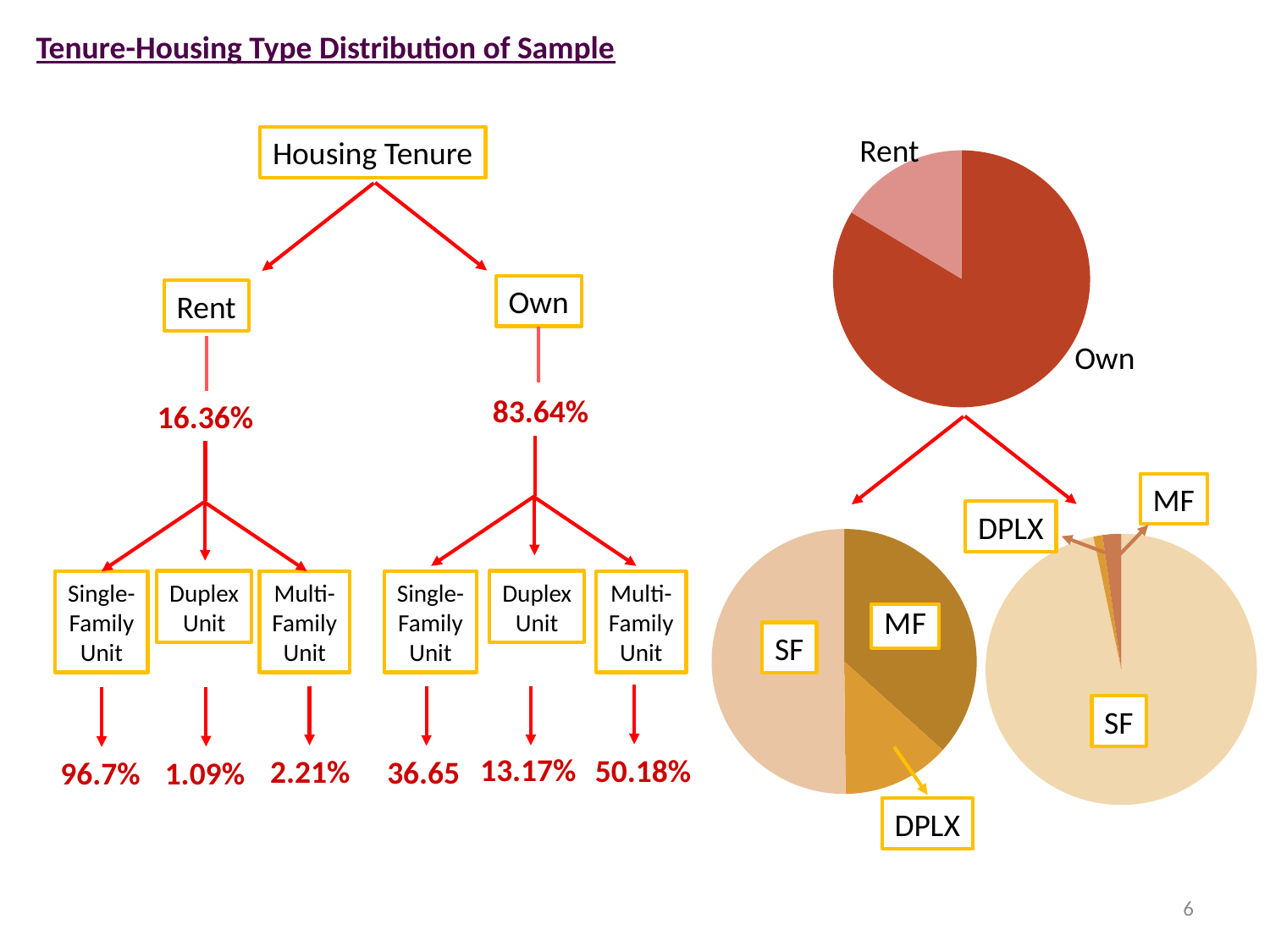
According to the tree diagram on the left, what is the value for Multi-Family Unit under Own? 50.18% What kind of chart is the top-right chart showing Rent and Own? pie chart In the bottom-left pie chart (SF, MF, DPLX), which slice is the largest? SF According to the tree diagram on the left, what percentage of the sample is Own? 83.64% In the bottom-right pie chart, which slice is the largest? SF In the bottom-right pie chart, which slice is larger, SF or MF? SF According to the tree diagram on the left, what percentage of the sample is Rent? 16.36% How many slices does the bottom-left pie chart have? 3 In the top-right pie chart, which slice is larger, Rent or Own? Own In the bottom-left pie chart (SF, MF, DPLX), which slice is the smallest? DPLX What is the title of the slide containing the pie charts? Tenure-Housing Type Distribution of Sample How many slices does the top-right pie chart (Rent/Own) have? 2